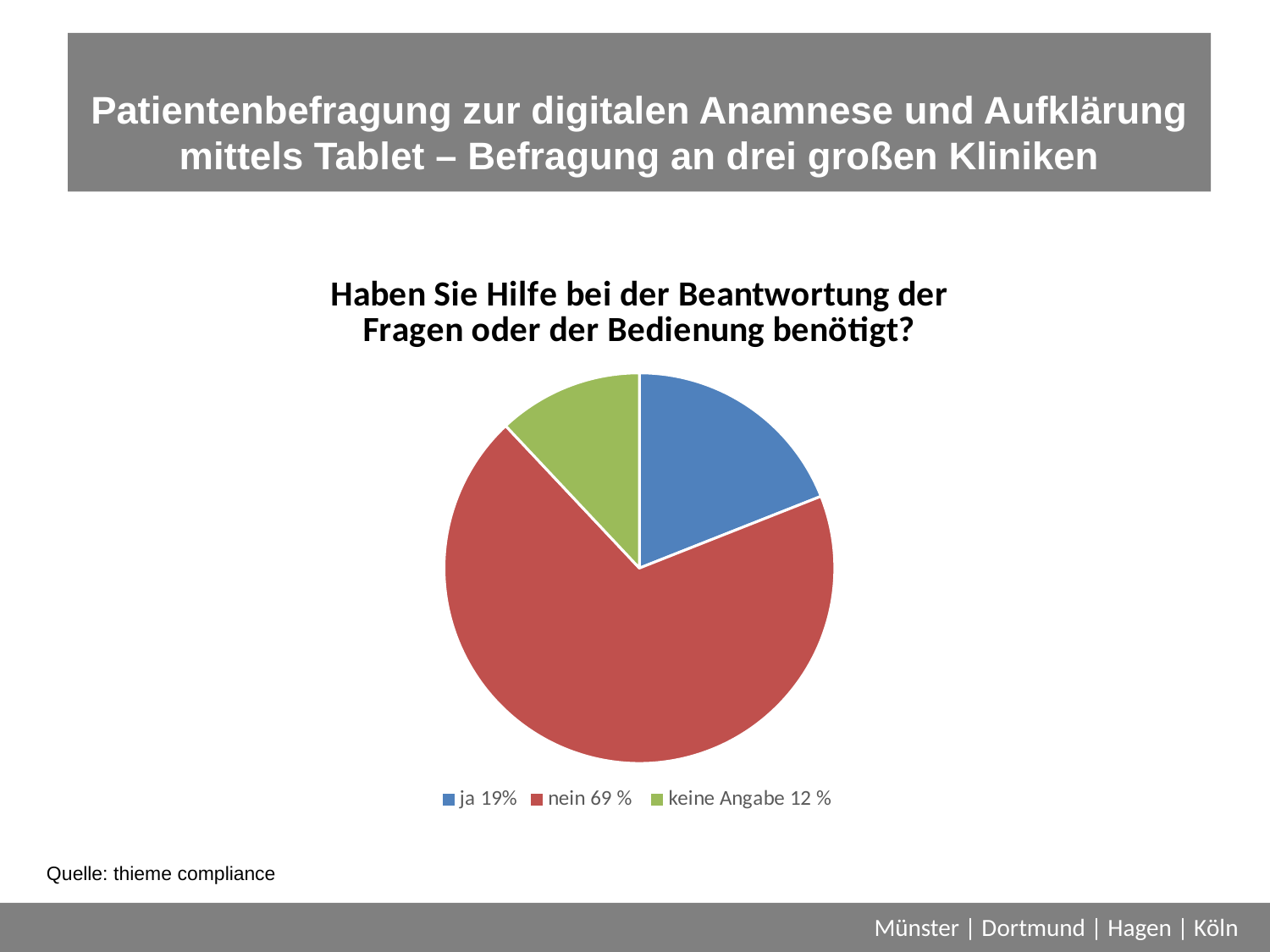
What share of the pie is 'nein'? 69 % How many entries does the legend list? 3 What is the chart's title? Haben Sie Hilfe bei der Beantwortung der Fragen oder der Bedienung benötigt? How many slices does the pie chart have? 3 What is the difference in percentage points between 'nein' and 'ja'? 50 Which is larger, the share for 'ja' or for 'keine Angabe'? ja Which category has the largest slice? nein What share of the pie is 'ja'? 19% What type of chart is shown on the slide? pie chart Which colour represents 'nein' in the pie chart? red Which category has the smallest slice? keine Angabe What share of the pie is 'keine Angabe'? 12 %